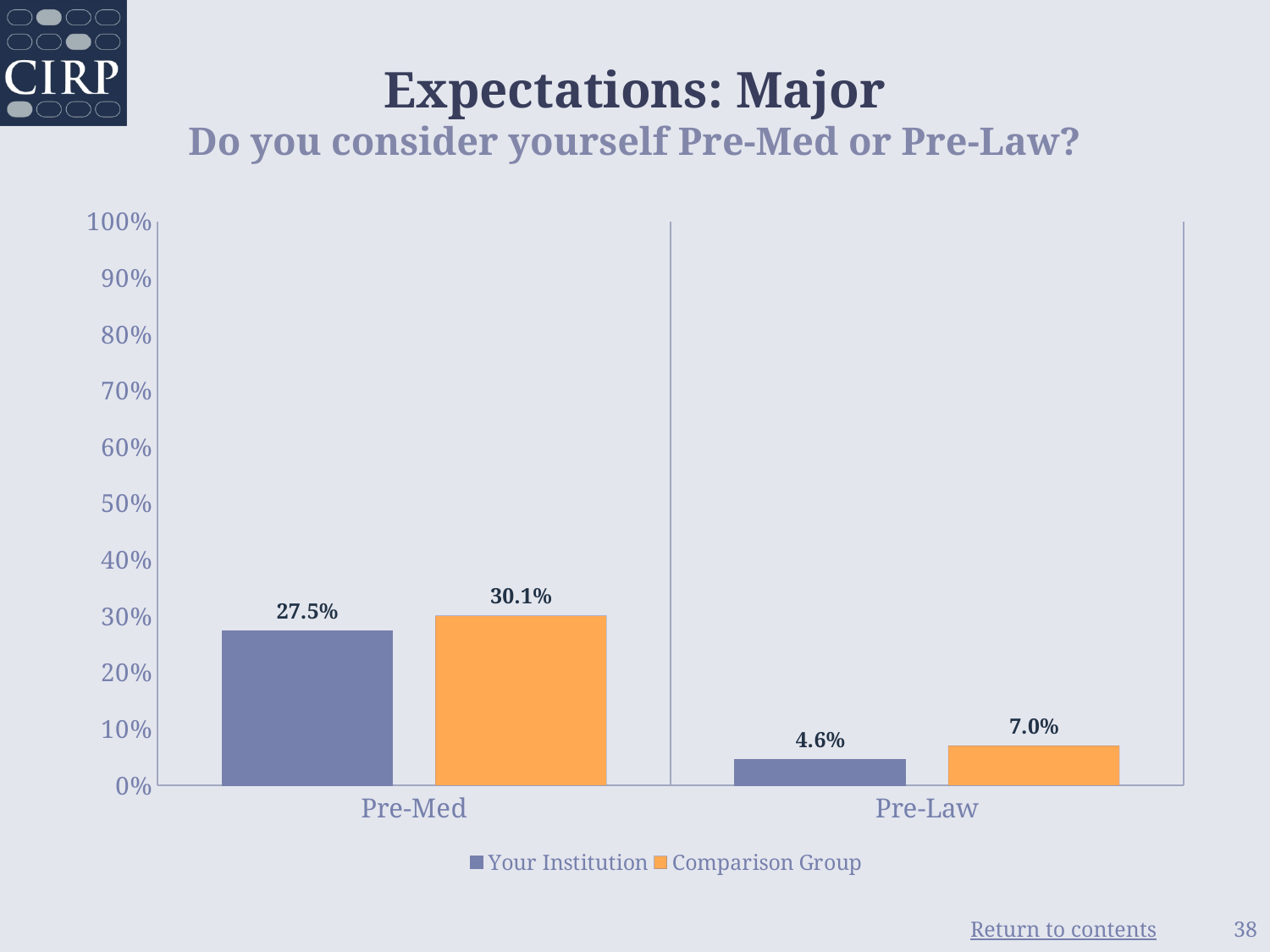
What percentage of Your Institution students consider themselves Pre-Med? 27.5% What is the Your Institution value for Pre-Law? 4.6% How many series does the legend list? 2 What is the Comparison Group value for Pre-Med? 30.1% What is the difference between the Comparison Group and Your Institution values for Pre-Med? 2.6% Which series has the lowest value in the Pre-Law category? Your Institution What is the Comparison Group value for Pre-Law? 7.0% What is the difference between the Comparison Group and Your Institution values for Pre-Law? 2.4% Is the Your Institution value for Pre-Med greater or less than 30%? less For Pre-Med, which is larger: Your Institution or Comparison Group? Comparison Group Which category has the highest value for the Comparison Group? Pre-Med What kind of chart is shown on the slide? Bar chart